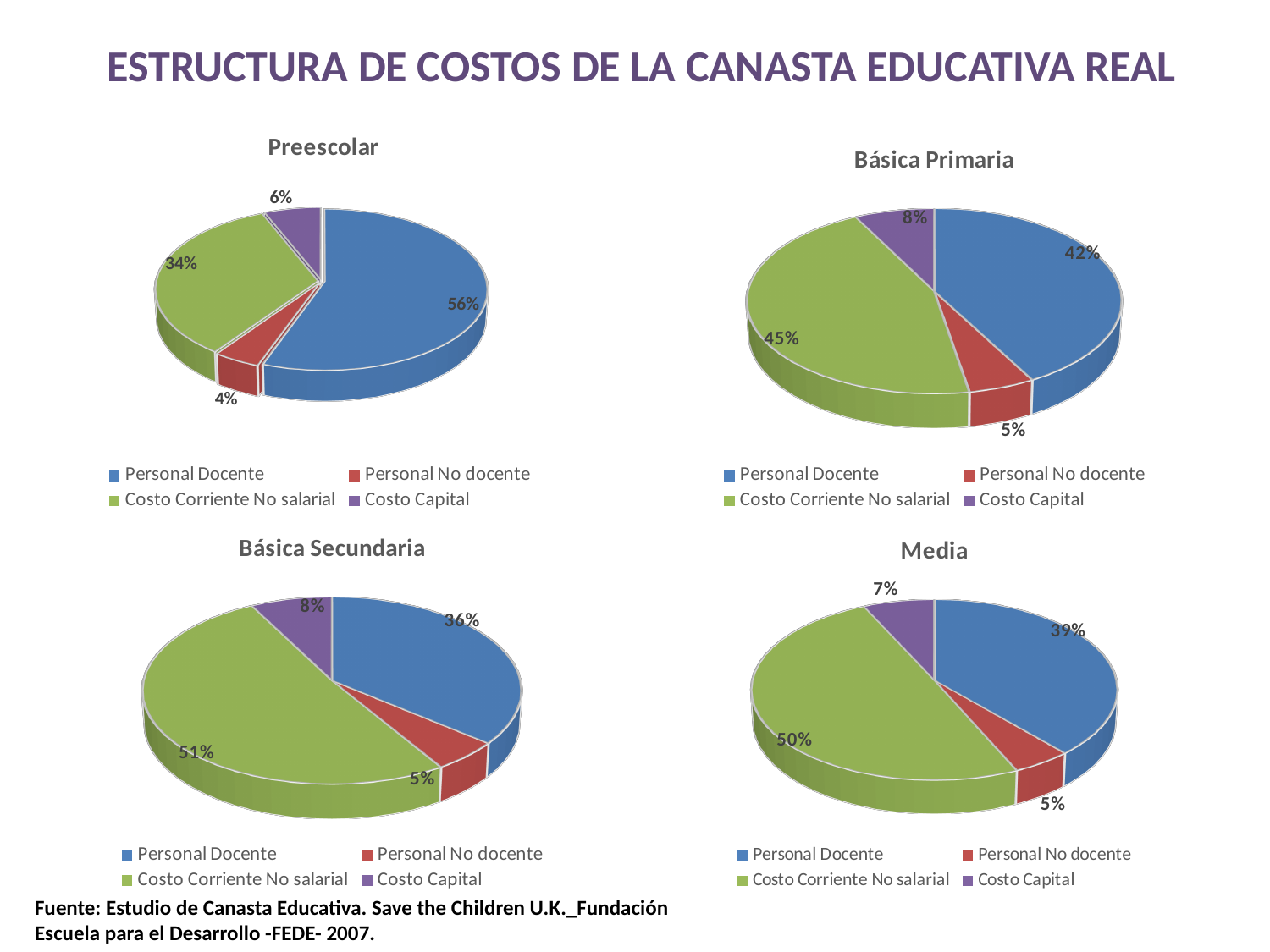
In the Preescolar chart, which is larger: the share of Costo Corriente No salarial or the share of Costo Capital? Costo Corriente No salarial In the Básica Primaria chart, what share does Costo Corriente No salarial have? 45% What kind of chart is the Básica Secundaria chart? Pie chart In the Básica Secundaria chart, what share does Costo Capital have? 8% How many slices does the Media chart have? 4 In the Básica Primaria chart, what is the difference between the shares of Costo Corriente No salarial and Personal Docente? 3% In the Media chart, which category has the largest share? Costo Corriente No salarial In the Preescolar chart, which category has the largest share? Personal Docente In the Preescolar chart, what share does Personal Docente have? 56% How many charts are shown on the slide? 4 In the Básica Secundaria chart, which category has the smallest share? Personal No docente In the Media chart, what share does Personal No docente have? 5%